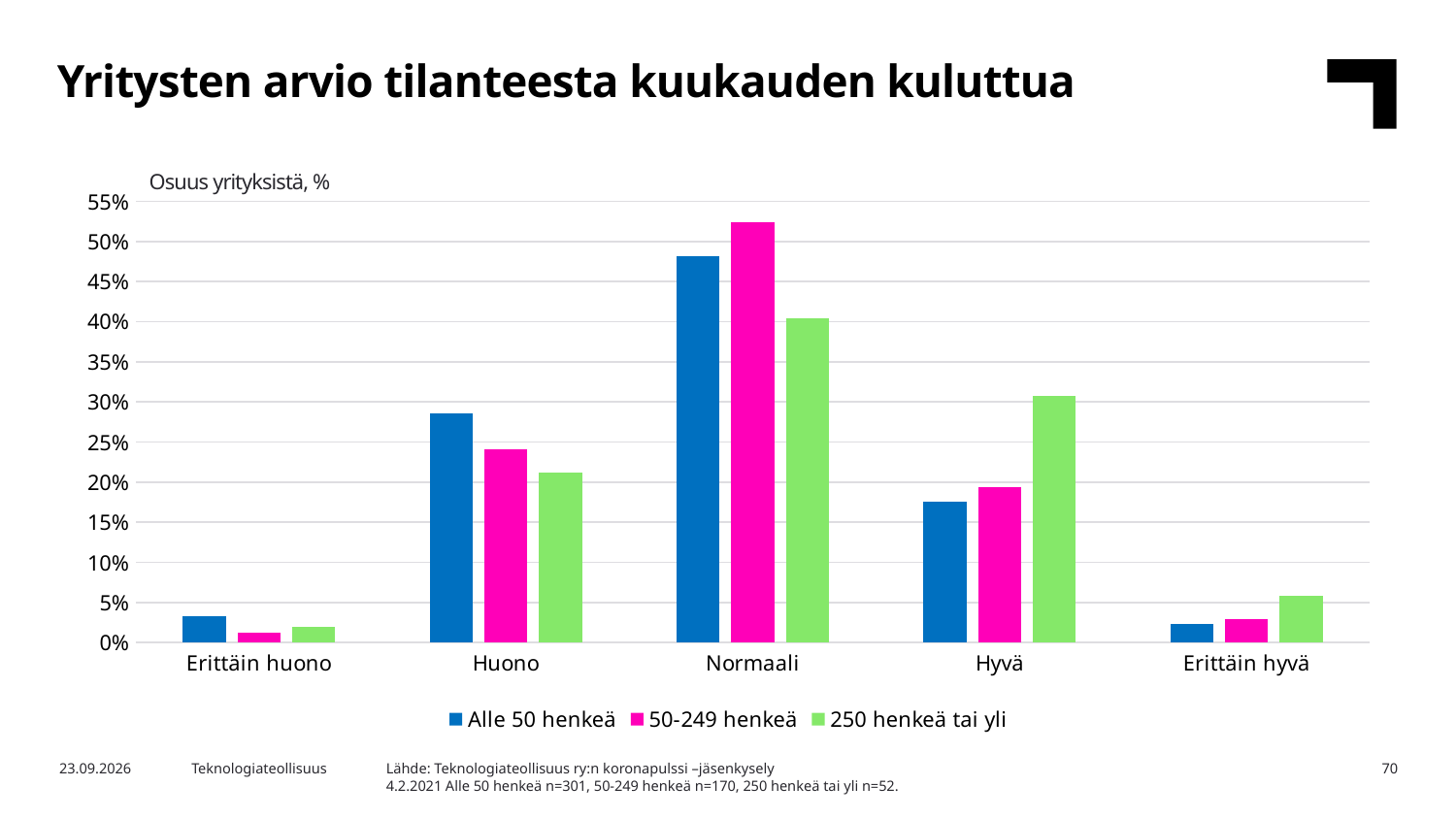
What is the title of the chart? Yritysten arvio tilanteesta kuukauden kuluttua In the Huono category, which series has the highest value? Alle 50 henkeä Is the value for Huono in the 250 henkeä tai yli series greater or less than 25%? less What kind of chart is shown on the slide? bar chart In the Hyvä category, which series has the larger value: Alle 50 henkeä or 250 henkeä tai yli? 250 henkeä tai yli How many categories are shown on the x axis? 5 What is the label shown above the vertical axis? Osuus yrityksistä, % Is the value for Huono in the Alle 50 henkeä series greater or less than 25%? greater Is the value for Normaali in the 250 henkeä tai yli series greater or less than 45%? less For the series 50-249 henkeä, which category has the highest value? Normaali How many series does the legend list? 3